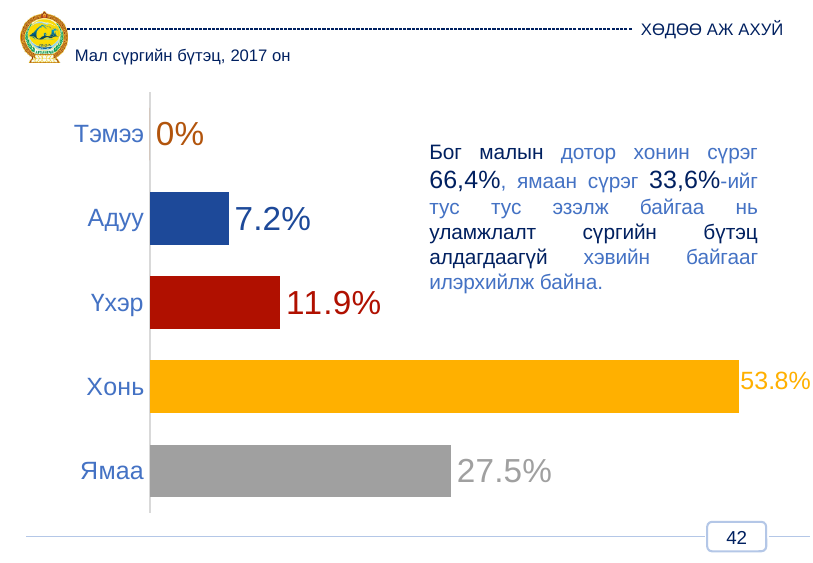
What is the value for Адуу? 7.2% What is the title of the chart? Мал сүргийн бүтэц, 2017 он What is the value for Тэмээ? 0% What is the value for Ямаа? 27.5% What is the value for Үхэр? 11.9% What is the difference between the values for Хонь and Ямаа? 26.3% Which category has the highest value? Хонь What kind of chart is shown on the slide? Bar chart Which is larger, the value for Үхэр or the value for Адуу? Үхэр Which category has the lowest value? Тэмээ What is the value for Хонь? 53.8% How many categories are shown in the chart? 5